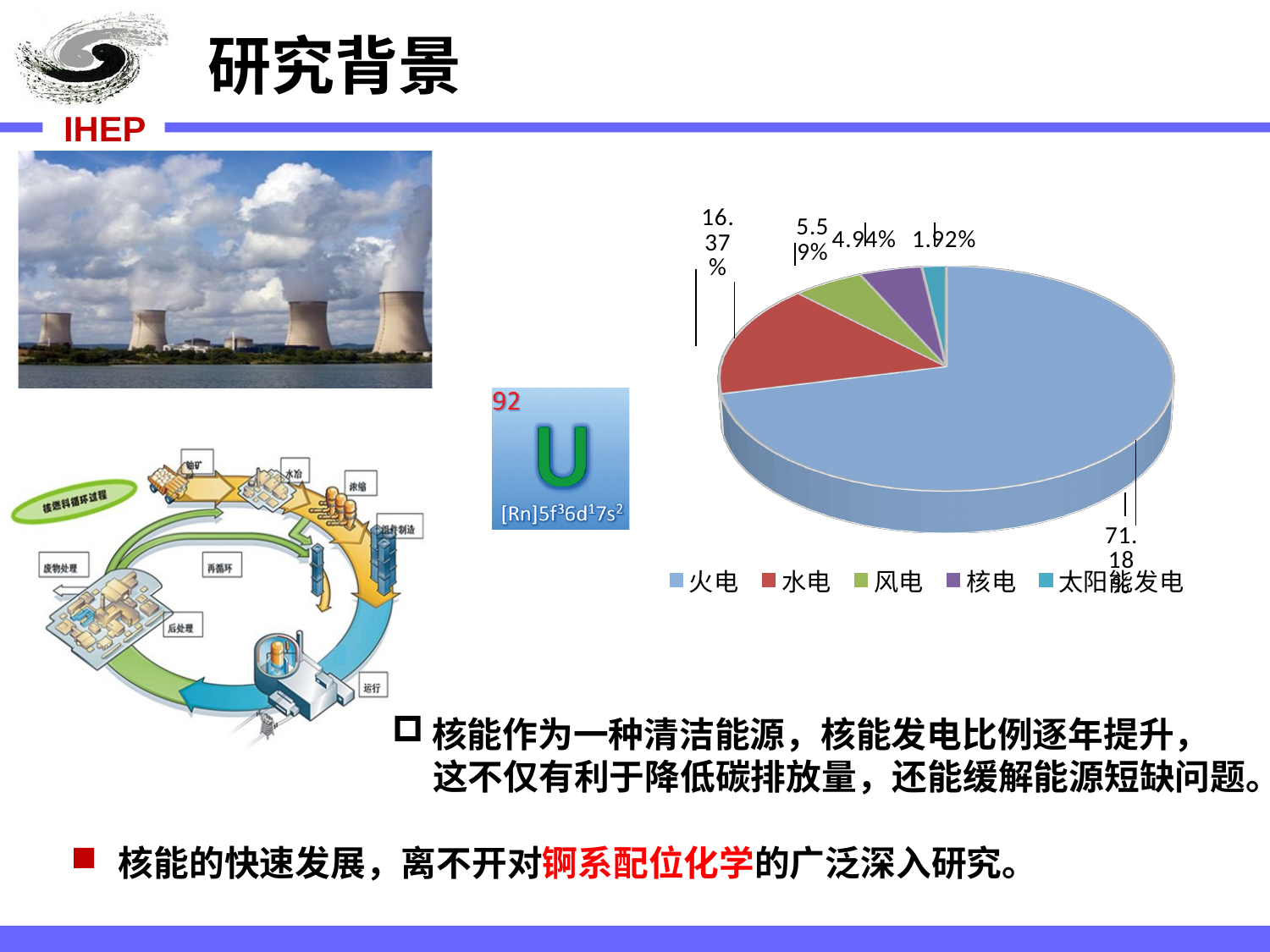
Which legend entry is shown in red in the pie chart? 水电 Which slice is larger in the pie chart, 水电 or 风电? 水电 How many categories does the pie chart's legend list? 5 What percentage is shown for 核电 in the pie chart? 4.94% Which category has the largest slice in the pie chart? 火电 What percentage is shown for 水电 in the pie chart? 16.37% Which slice is larger in the pie chart, 核电 or 太阳能发电? 核电 What percentage is shown for 太阳能发电 in the pie chart? 1.92% How many slices does the pie chart have? 5 What is the difference between the percentages for 水电 and 核电 in the pie chart? 11.43% Which category has the smallest slice in the pie chart? 太阳能发电 What kind of chart is shown on the slide? pie chart